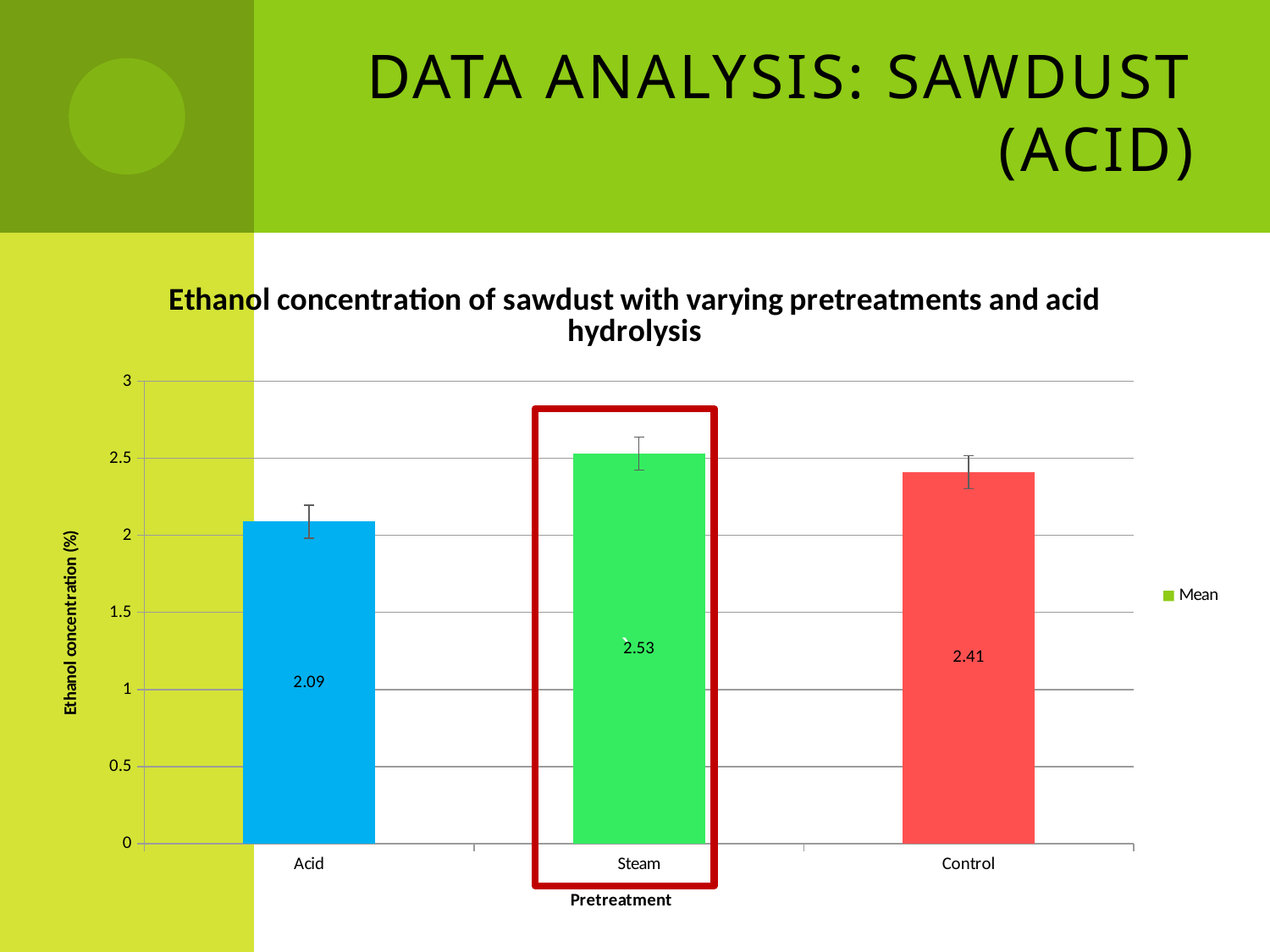
Is the value for Acid greater or less than 2.5? less How many pretreatment categories are shown on the x axis? 3 What is the difference in ethanol concentration between Control and Acid? 0.32 What is the ethanol concentration for the Steam pretreatment? 2.53 Which pretreatment has the lowest ethanol concentration? Acid What is the ethanol concentration for the Acid pretreatment? 2.09 What kind of chart is shown on the slide? Bar chart What is the difference in ethanol concentration between Steam and Acid? 0.44 Which has a higher ethanol concentration, Steam or Control? Steam What series name does the legend list? Mean What is the ethanol concentration for the Control? 2.41 Which pretreatment has the highest ethanol concentration? Steam